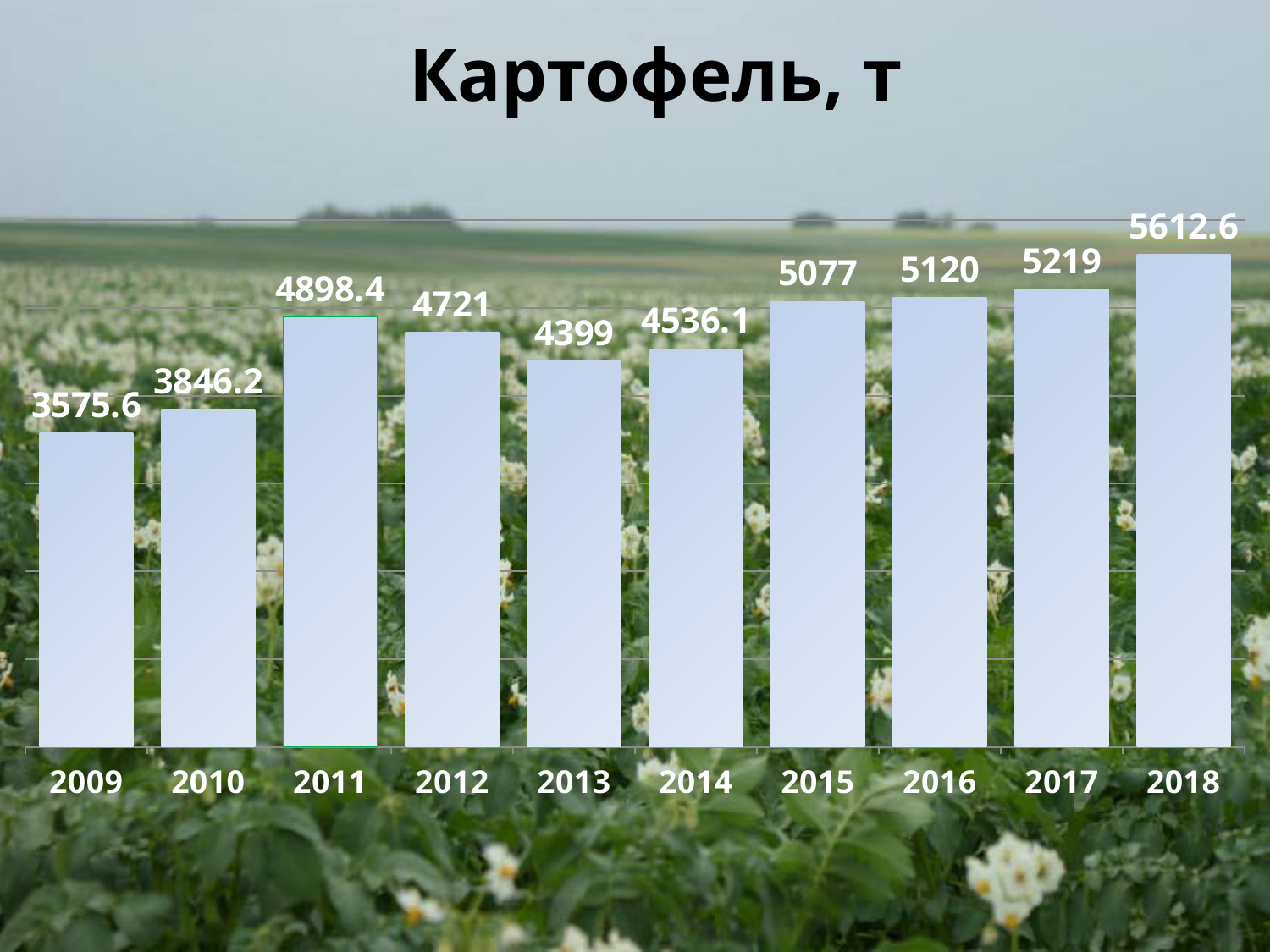
Do the values rise or fall from 2013 to 2018? rise What is the title of the chart? Картофель, т What is the difference between the values for 2016 and 2015? 43 Which year has the highest value? 2018 Which year has the lowest value? 2009 How many years are shown on the chart? 10 What is the difference between the values for 2018 and 2009? 2037 Which is larger, the value for 2011 or the value for 2012? 2011 What kind of chart is this? bar chart What is the value for 2017? 5219 What is the value for 2009? 3575.6 What is the value for 2014? 4536.1